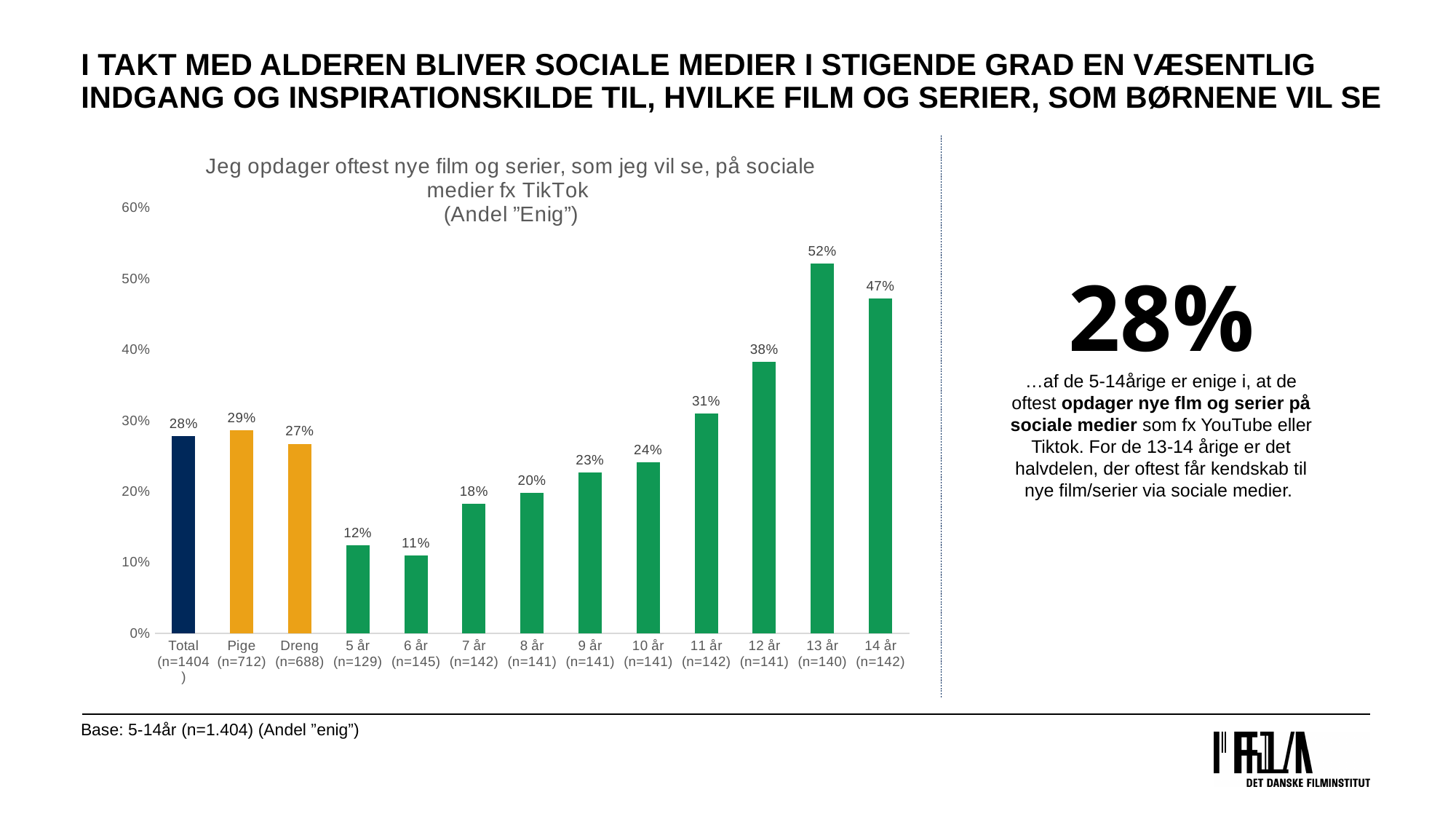
What is the value for 8 år (n=141)? 20% Which category has the highest value? 13 år (n=140) Do the values generally rise or fall from 5 år to 13 år? rise What kind of chart is shown on the slide? bar chart How many categories are shown on the x axis? 13 What is the value for 13 år (n=140)? 52% What is the value for Pige (n=712)? 29% Which category has the lowest value? 6 år (n=145) What is the difference between the values for 14 år and 5 år? 35% What is the value for Total (n=1404)? 28% Is the value for 12 år greater or less than 40%? less Which is larger, the value for Pige or the value for Dreng? Pige